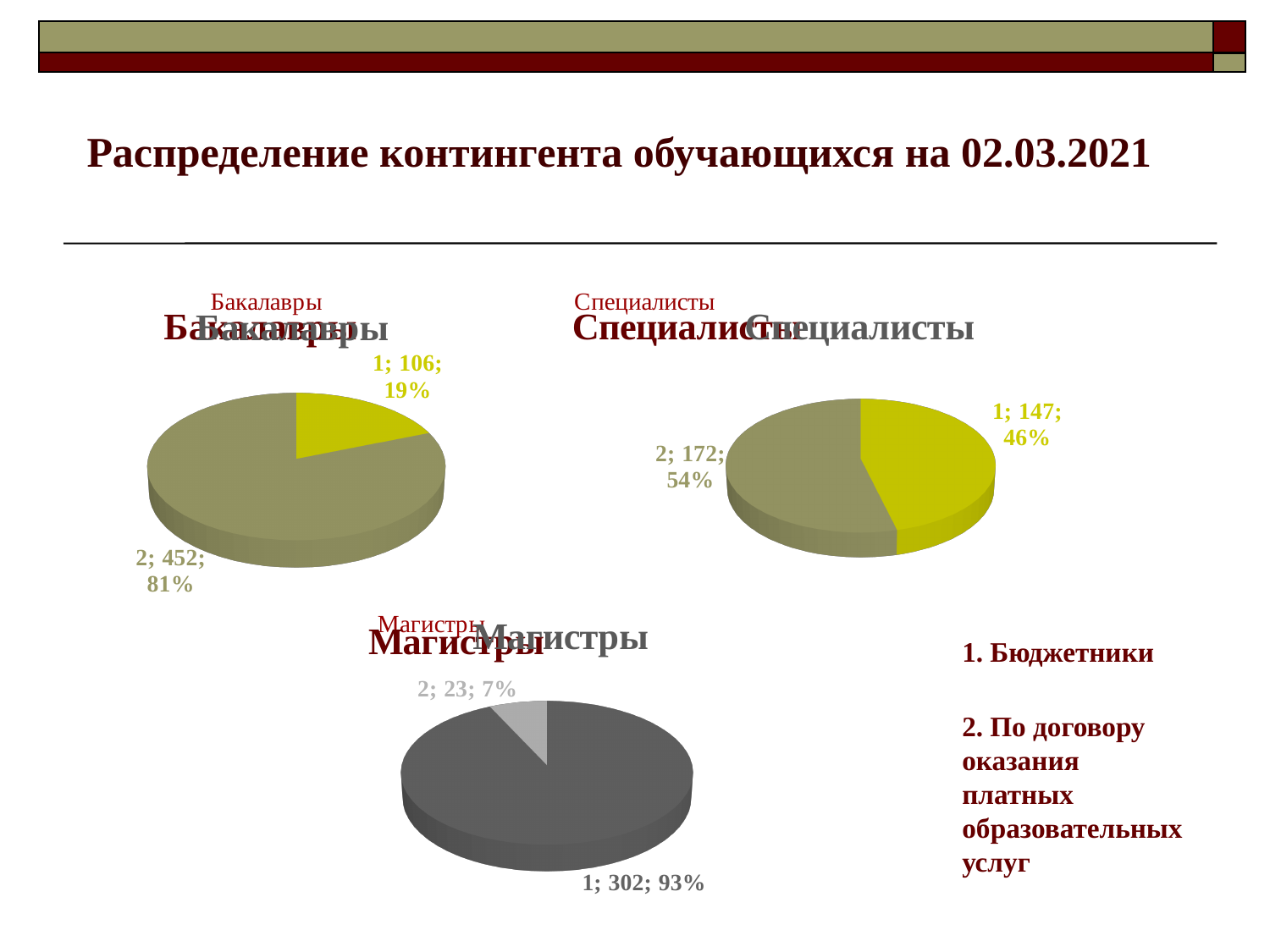
What kind of chart is the "Бакалавры" chart? pie chart In the "Бакалавры" chart, which category is larger, 1 or 2? 2 According to the key on the slide, what does category 1 stand for? Бюджетники In the "Специалисты" chart, what is the difference between the values for category 2 and category 1? 25 In the "Специалисты" chart, what is the value for category 2? 172 In the "Магистры" chart, what is the value for category 1? 302 In the "Специалисты" chart, what share of the pie does category 1 have? 46% In the "Магистры" chart, what is the total of the two slices? 325 How many slices does the "Специалисты" chart have? 2 In the "Бакалавры" chart, what is the value for category 1? 106 In the "Бакалавры" chart, what share of the pie does category 2 have? 81% In the "Магистры" chart, which category has the smallest slice? 2